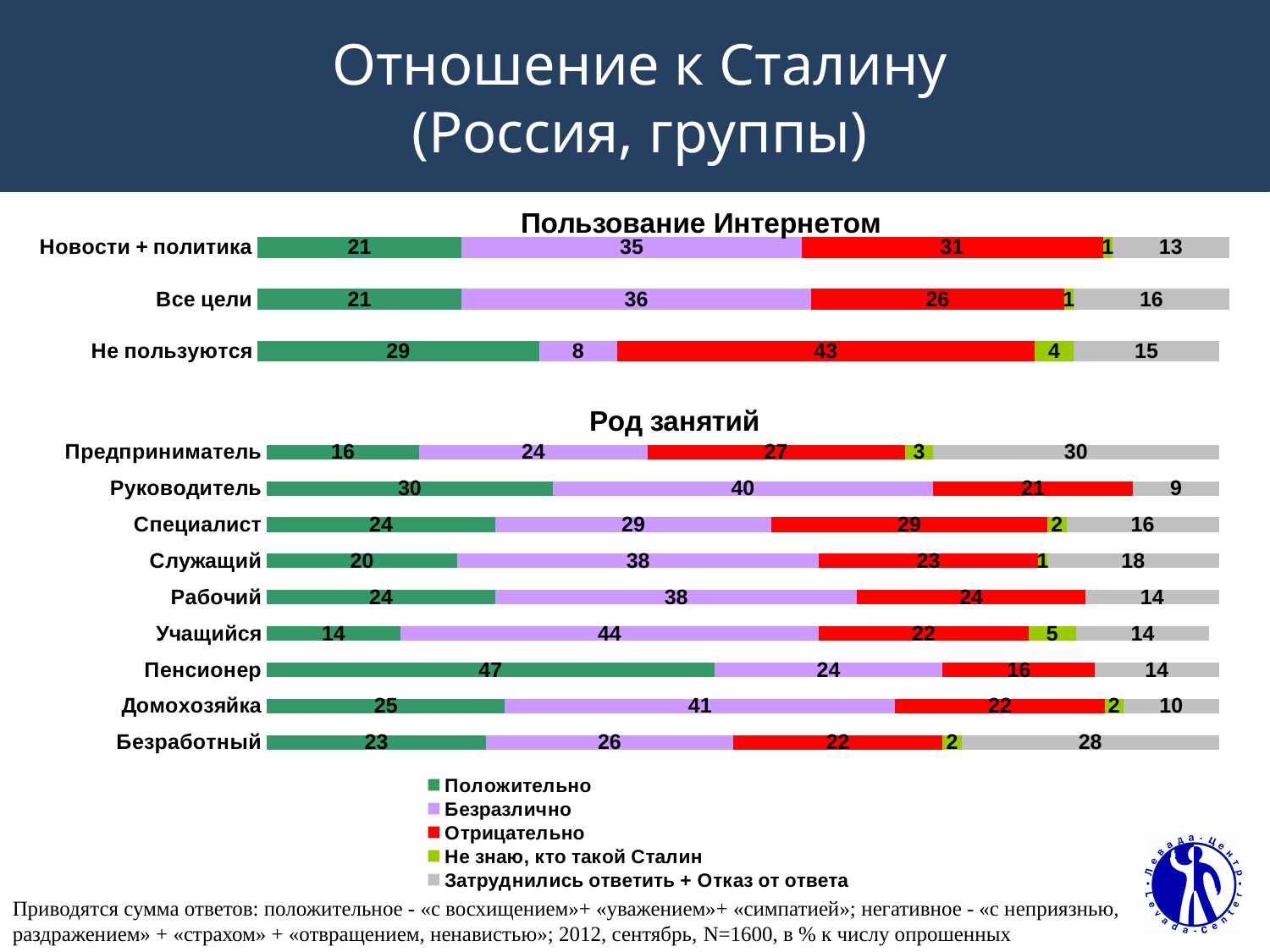
How many categories are shown in the 'Род занятий' chart? 9 In the 'Род занятий' chart, which category has the lowest 'Положительно' value? Учащийся In the 'Пользование Интернетом' chart, what is the difference between the 'Безразлично' values for 'Все цели' and 'Не пользуются'? 28 In the 'Род занятий' chart, what is the value of 'Положительно' for 'Пенсионер'? 47 What type of chart is the 'Пользование Интернетом' chart? Stacked bar chart In the 'Пользование Интернетом' chart, what is the total of the stacked bar for 'Все цели'? 100 In the 'Род занятий' chart, which category has the highest 'Безразлично' value? Учащийся In the 'Род занятий' chart, which has the larger 'Отрицательно' value: 'Предприниматель' or 'Руководитель'? Предприниматель Which colour represents 'Отрицательно' in the legend? Red In the 'Пользование Интернетом' chart, what is the value of 'Отрицательно' for 'Не пользуются'? 43 In the 'Род занятий' chart, which category has the highest 'Положительно' value? Пенсионер How many series does the legend list? 5